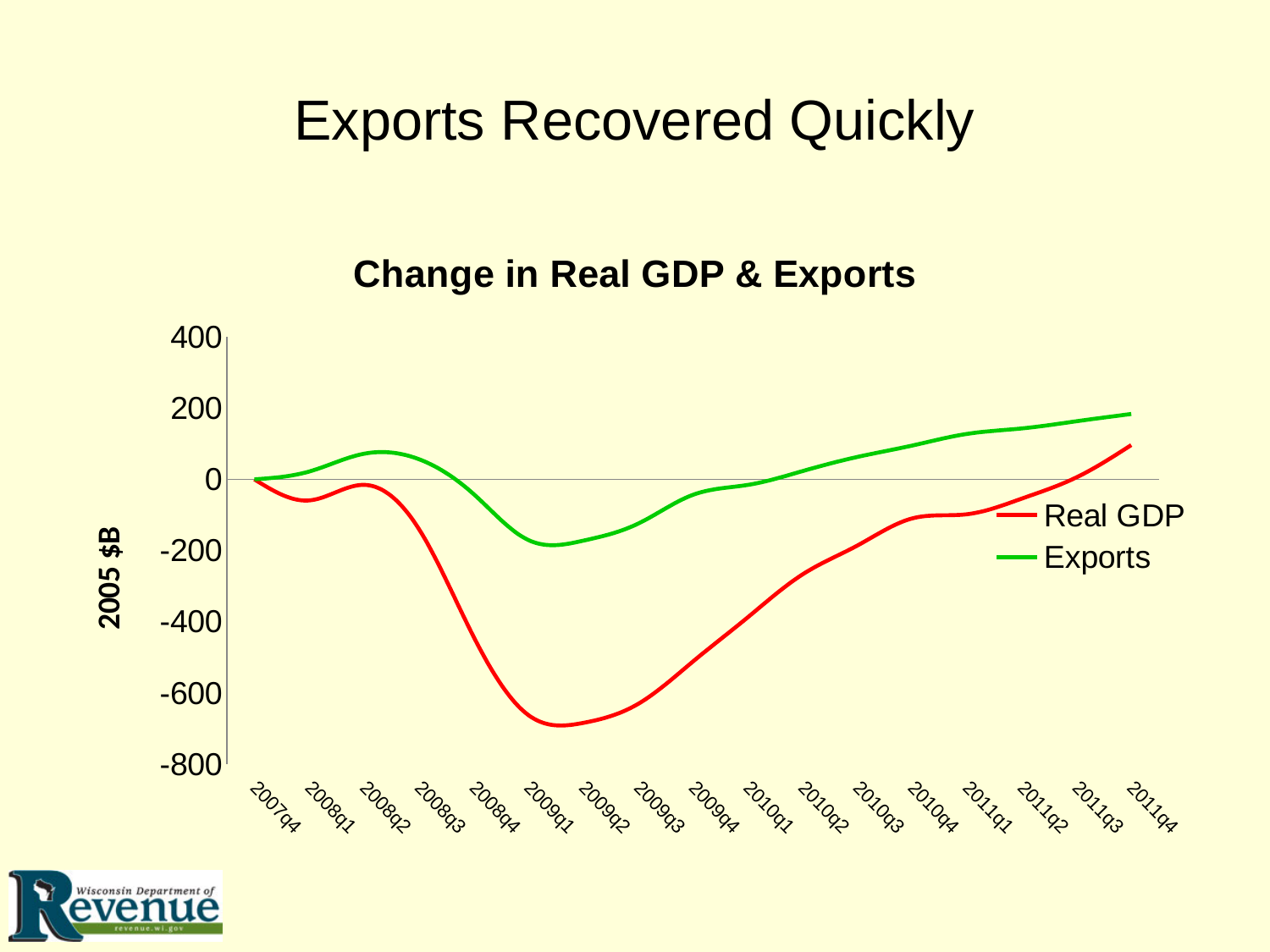
Is the value for Real GDP at 2009q2 greater or less than -600? less Does the Real GDP line rise or fall from 2009q2 to 2011q4? rise Is the value for Exports at 2011q4 greater or less than 100? greater At 2009q2, which series has the higher value, Real GDP or Exports? Exports What is the label on the vertical axis? 2005 $B Is the value for Real GDP at 2011q4 greater or less than 0? greater How many series does the legend list? 2 What is the title of the chart? Change in Real GDP & Exports How many quarters are plotted along the x axis? 17 What kind of chart is shown on the slide? line chart